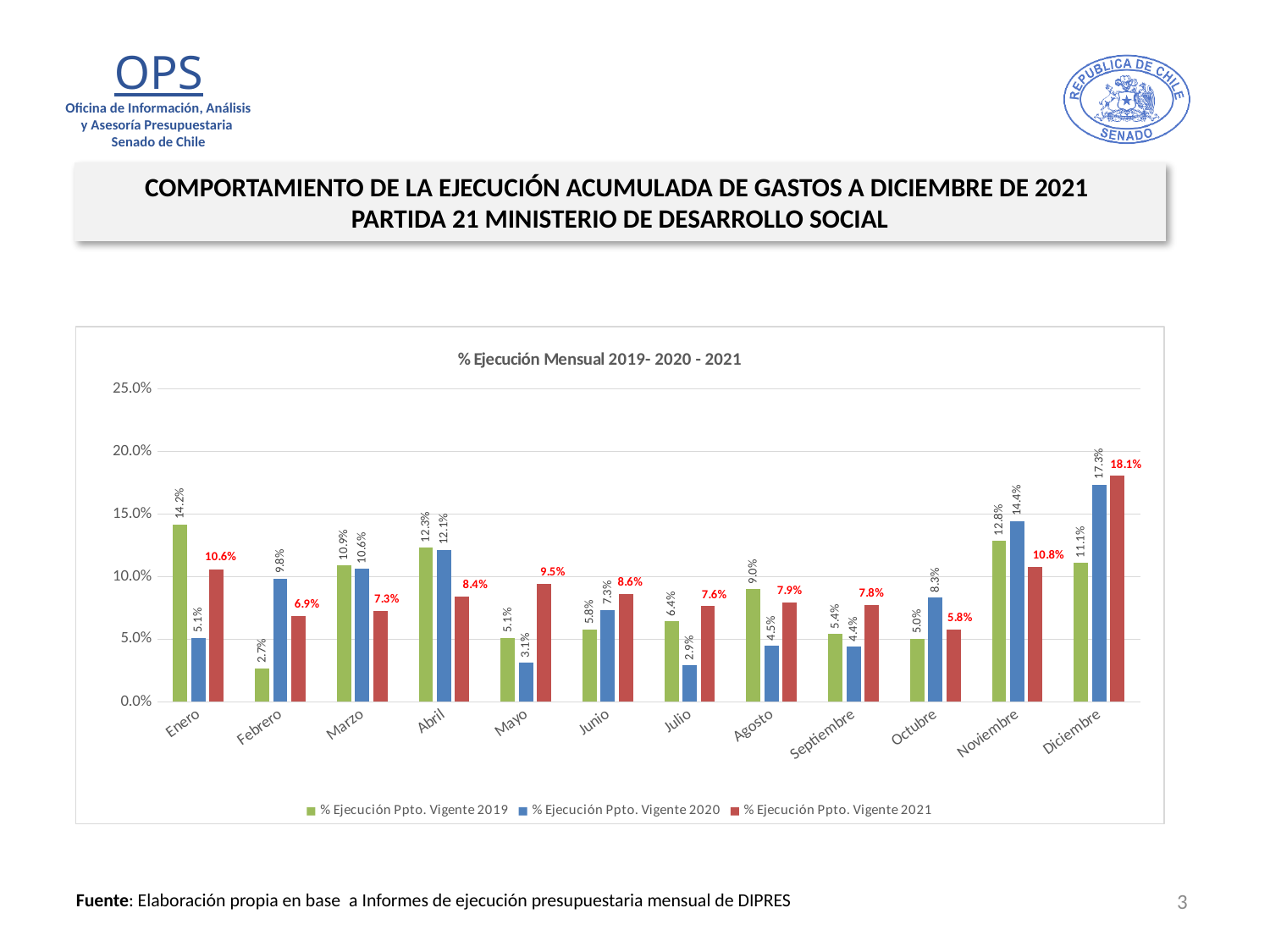
What is the value for % Ejecución Ppto. Vigente 2021 in Diciembre? 18.1% Which month has the lowest value for % Ejecución Ppto. Vigente 2020? Julio What is the value for % Ejecución Ppto. Vigente 2019 in Enero? 14.2% Is the value for % Ejecución Ppto. Vigente 2020 in Diciembre greater or less than 15.0%? greater How many months are shown on the x axis? 12 What kind of chart is shown on the slide? Bar chart What is the difference between the 2021 and 2020 values in Enero? 5.5% What is the value for % Ejecución Ppto. Vigente 2020 in Noviembre? 14.4% Which month has the lowest value for % Ejecución Ppto. Vigente 2019? Febrero How many series does the legend list? 3 In Mayo, which series has the larger value: % Ejecución Ppto. Vigente 2019 or % Ejecución Ppto. Vigente 2021? % Ejecución Ppto. Vigente 2021 Which month has the highest value for % Ejecución Ppto. Vigente 2021? Diciembre